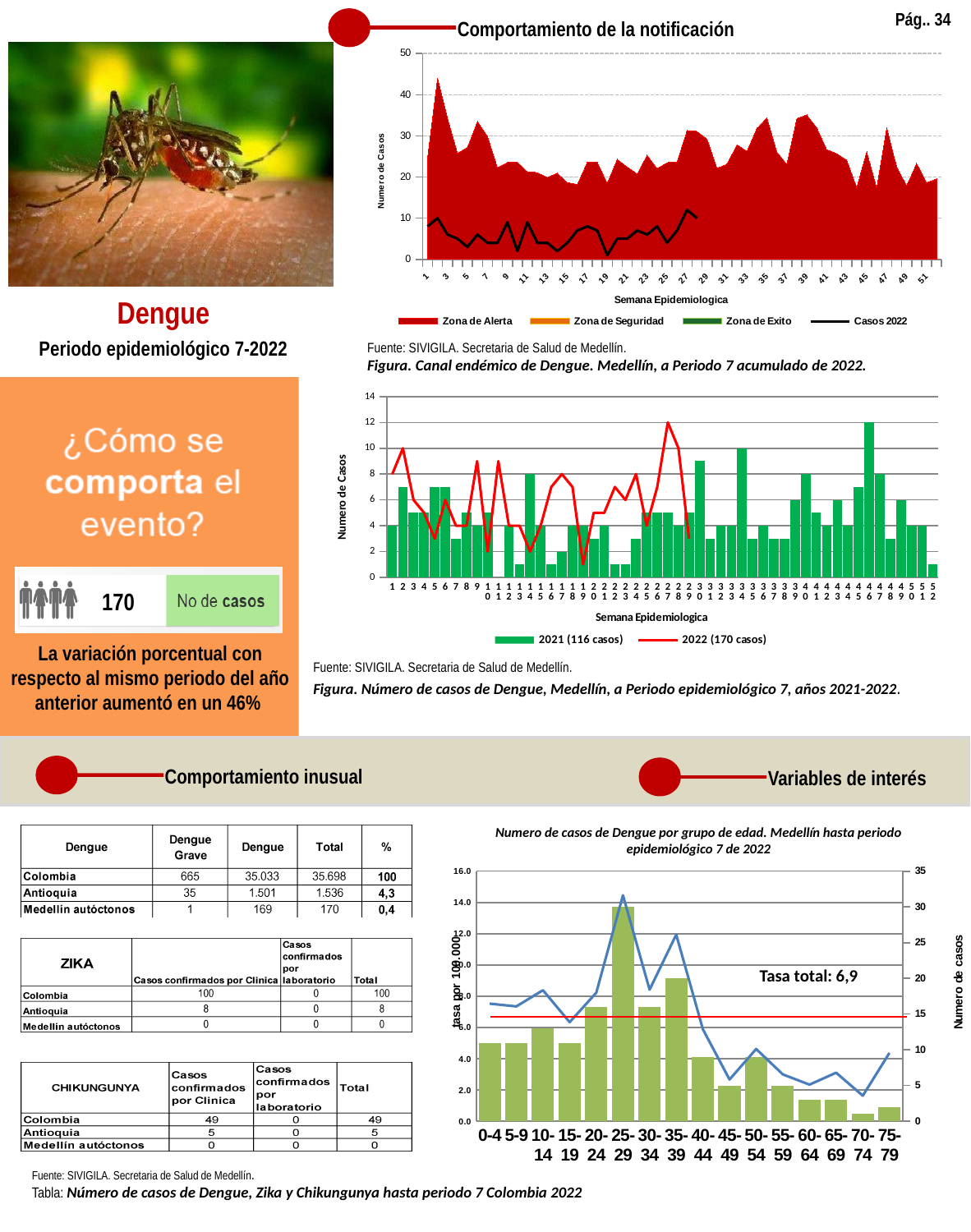
In the middle chart (Número de casos de Dengue, años 2021-2022), what colour are the bars for the 2021 series? green In the chart titled 'Numero de casos de Dengue por grupo de edad', how many age groups are shown on the x axis? 16 In the top chart (Canal endémico de Dengue), how many entries does the legend list? 4 In the chart titled 'Numero de casos de Dengue por grupo de edad', which age group has the lowest number of cases? 70-74 In the middle chart (Número de casos de Dengue, años 2021-2022), how many cases does the legend give for 2021? 116 casos In the chart titled 'Numero de casos de Dengue por grupo de edad', is the number of cases for the 25-29 age group greater or less than 25? greater In the chart titled 'Numero de casos de Dengue por grupo de edad', do the bars rise or fall from the 25-29 age group to the 45-49 age group? fall In the chart titled 'Numero de casos de Dengue por grupo de edad', what is the 'Tasa total' value printed on the chart? 6,9 In the chart titled 'Numero de casos de Dengue por grupo de edad', which age group has more cases, 30-34 or 35-39? 35-39 In the chart titled 'Numero de casos de Dengue por grupo de edad', which age group has the highest number of cases? 25-29 In the middle chart (Número de casos de Dengue, años 2021-2022), which epidemiological week has the highest 2021 bar? 46 In the middle chart (Número de casos de Dengue, años 2021-2022), how many series does the legend list? 2